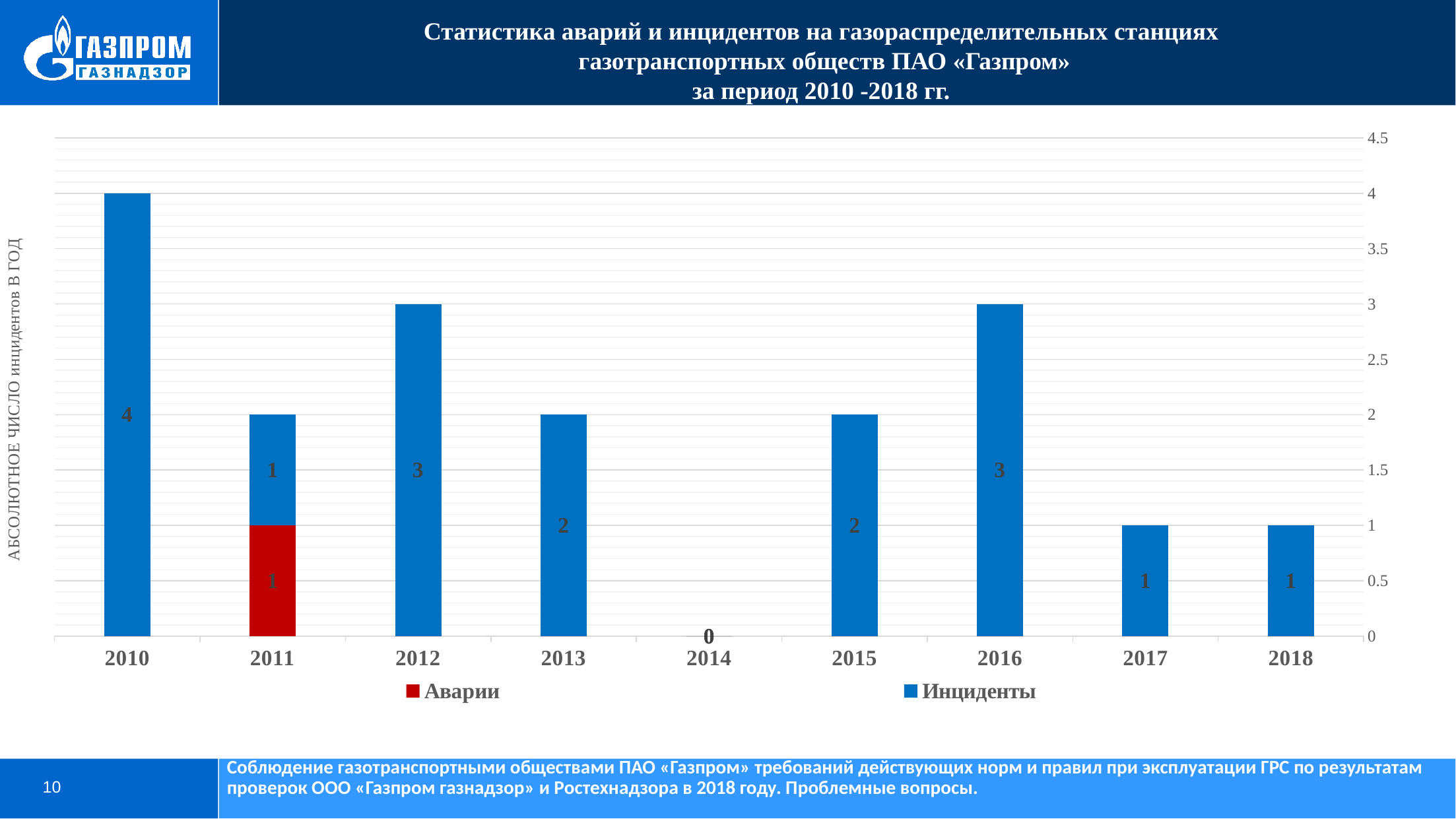
What is the difference between the Инциденты values for 2010 and 2018? 3 Which colour represents Аварии in the legend? red How many series does the legend list? 2 What is the value of Инциденты for 2010? 4 What is the value shown for 2014? 0 Which year has the highest number of Инциденты? 2010 What type of chart is shown on the slide? bar chart How many years are shown on the x axis? 9 Which year has the lowest total value? 2014 What is the value of Инциденты for 2016? 3 What is the value of Аварии for 2011? 1 What is the total of the stacked bar for 2011? 2